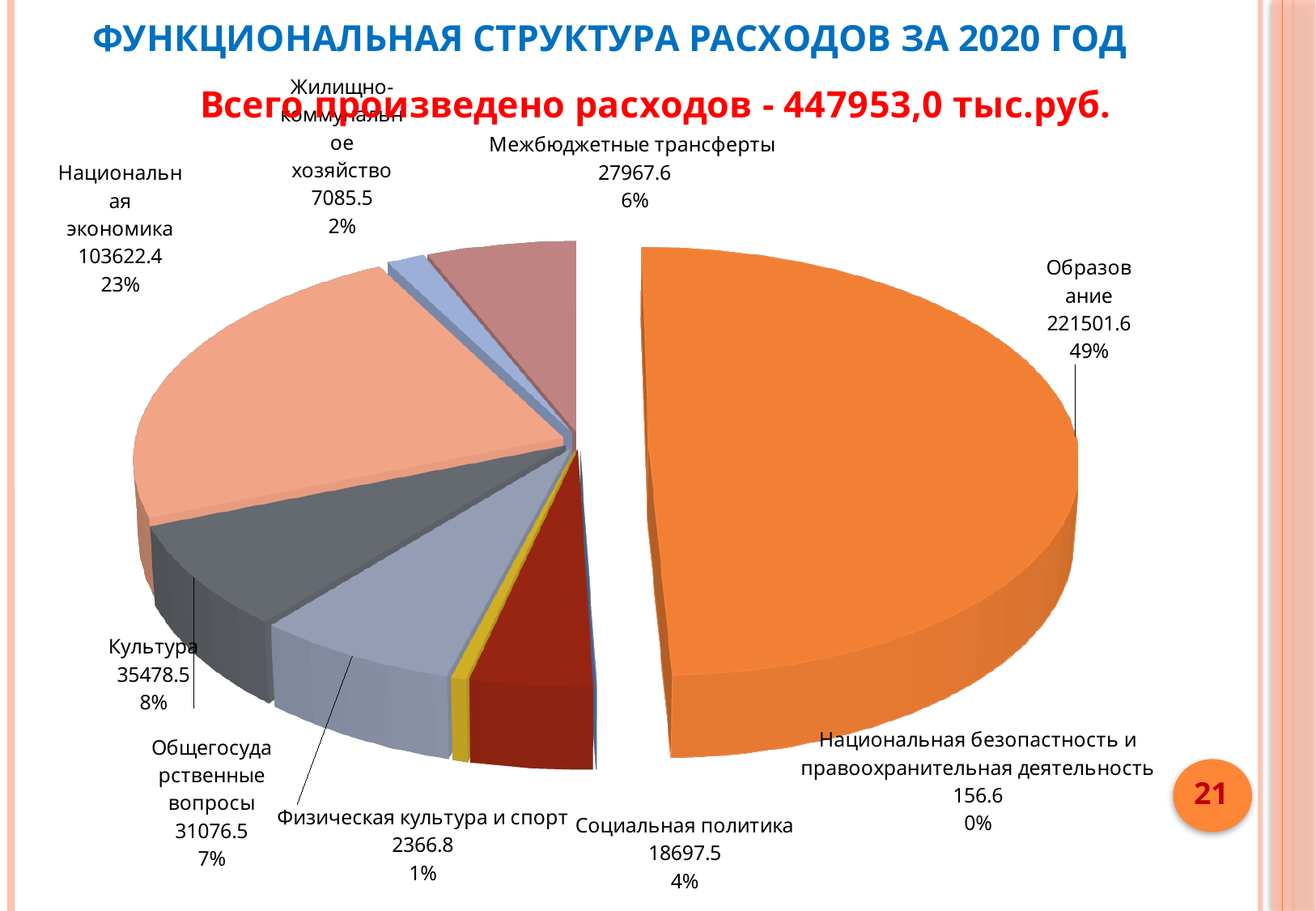
What share of the pie does Национальная экономика represent? 23% Which is larger, the value for Социальная политика or the value for Жилищно-коммунальное хозяйство? Социальная политика Which category has the smallest slice of the pie? Национальная безопастность и правоохранительная деятельность What is the difference between the values for Общегосударственные вопросы and Межбюджетные трансферты? 3108.9 What is the title of the slide? ФУНКЦИОНАЛЬНАЯ СТРУКТУРА РАСХОДОВ ЗА 2020 ГОД What is the value shown for Культура? 35478.5 What is the value shown for Образование? 221501.6 What is the value shown for Межбюджетные трансферты? 27967.6 Which category has the largest slice of the pie? Образование What percentage is shown for Физическая культура и спорт? 1% What kind of chart is shown on the slide? pie chart How many categories are shown in the pie chart? 9